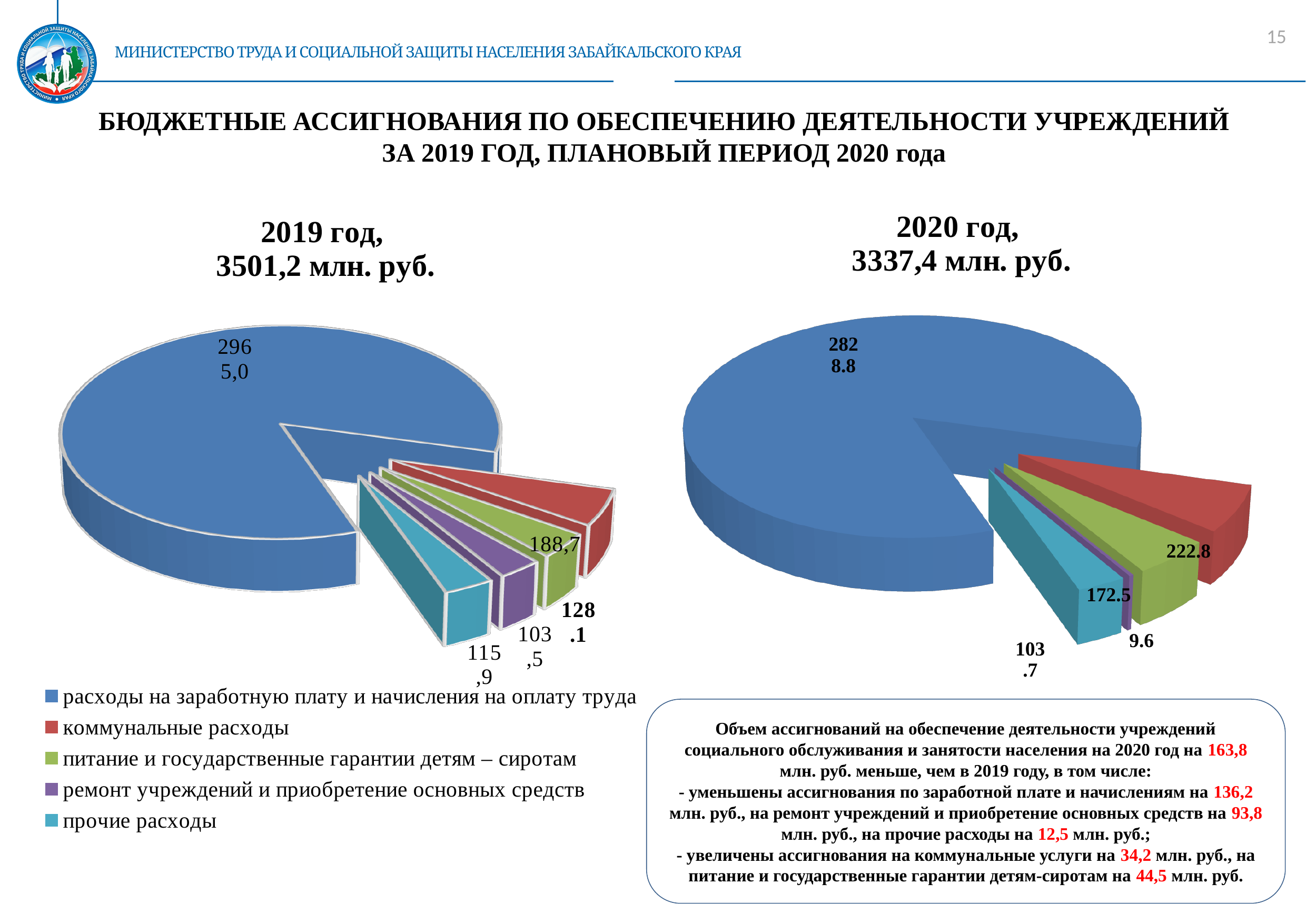
What kind of chart is used for the 2019 год data on the slide? pie chart In the 2019 год pie chart, what is the value for расходы на заработную плату и начисления на оплату труда? 2965,0 How many slices does the 2020 год pie chart have? 5 What total is shown in the title of the 2019 год pie chart? 3501,2 млн. руб. In the 2020 год pie chart, what is the value for коммунальные расходы? 222.8 In the 2020 год pie chart, which category has the smallest slice? ремонт учреждений и приобретение основных средств In the 2019 год pie chart, which category has the smallest value? ремонт учреждений и приобретение основных средств In the 2020 год pie chart, what is the value for ремонт учреждений и приобретение основных средств? 9.6 In the 2019 год pie chart, what is the value for прочие расходы? 115,9 In the 2019 год pie chart, which category has the largest slice? расходы на заработную плату и начисления на оплату труда In the 2019 год pie chart, which is larger: коммунальные расходы or прочие расходы? коммунальные расходы In the 2020 год pie chart, what is the difference between коммунальные расходы and питание и государственные гарантии детям – сиротам? 50.3